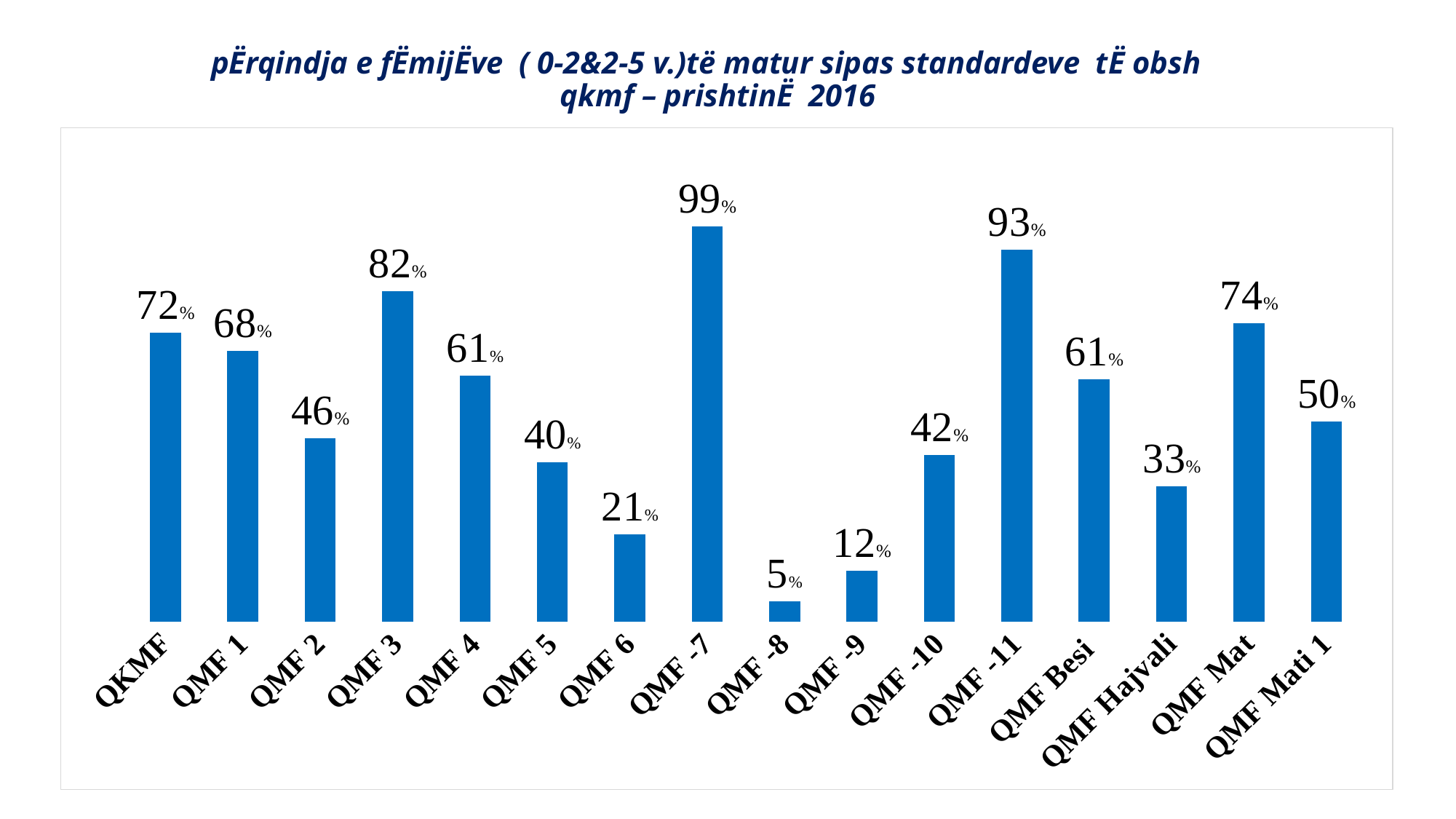
Which category has the highest value? QMF -7 What is the value for QMF 3? 82% Which is larger, the value for QMF Mat or the value for QMF Mati 1? QMF Mat What is the difference between the values for QMF -7 and QMF -11? 6% What is the value for QMF Hajvali? 33% What year is mentioned in the chart title? 2016 What is the difference between the values for QKMF and QMF 1? 4% How many categories are shown on the x axis? 16 Which category has the lowest value? QMF -8 What kind of chart is shown on the slide? Bar chart What is the value for QMF -10? 42% Which is larger, the value for QMF 2 or the value for QMF 5? QMF 2